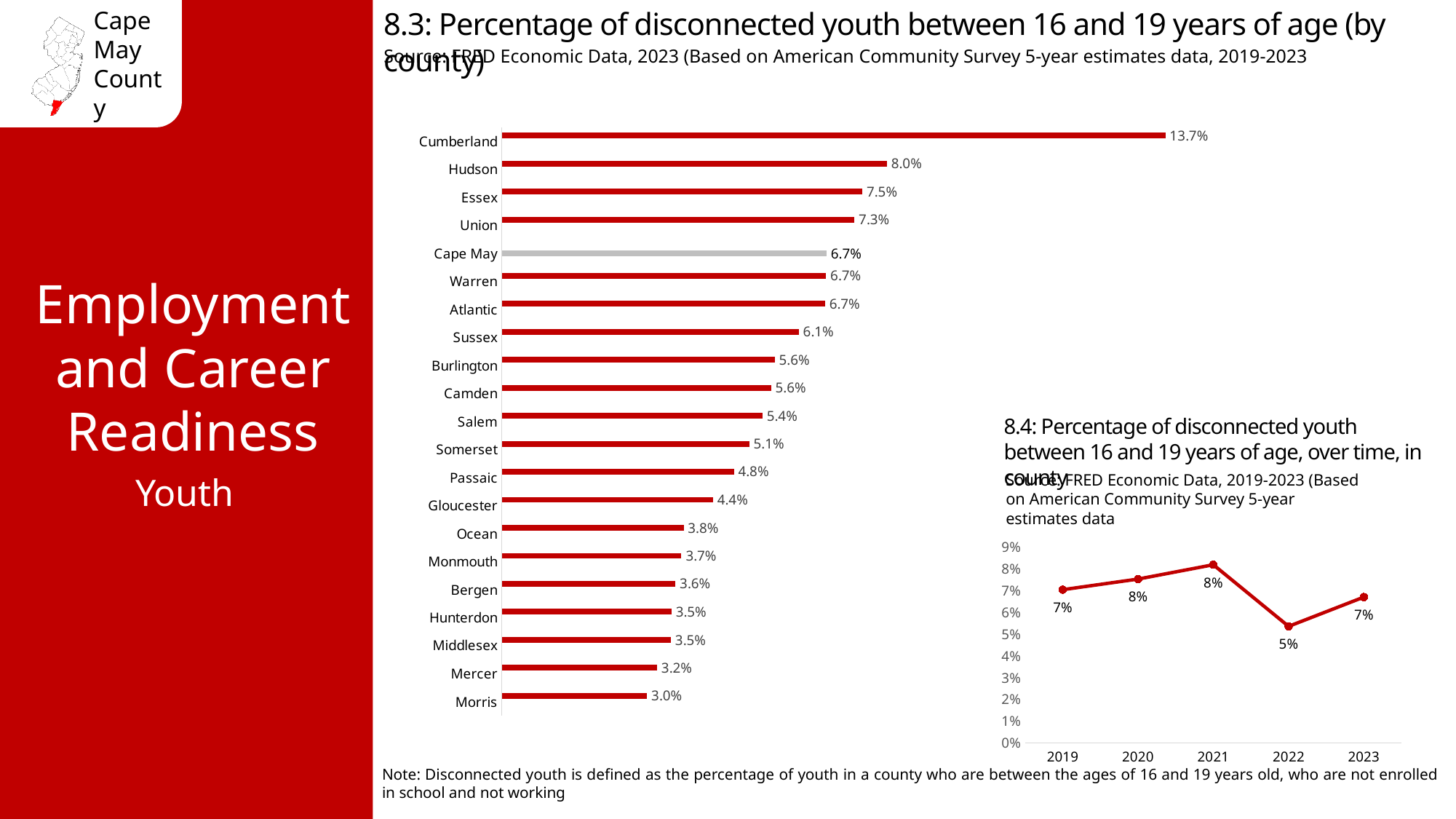
In the chart 8.3 (by county), how many counties are shown? 21 In the chart 8.3 (by county), which county's bar is shown in grey instead of red? Cape May In the chart 8.3 (by county), what is the difference between Cumberland's value and Hudson's value? 5.7 percentage points In the chart 8.3 (by county), what is the value for Mercer? 3.2% What kind of chart is chart 8.3 (by county)? Bar chart In the chart 8.3 (by county), which county has a higher value, Essex or Gloucester? Essex In the chart 8.4 (over time), which year has the lowest value? 2022 In the chart 8.4 (over time), how many years are plotted? 5 In the chart 8.3 (by county), which county has the lowest percentage of disconnected youth? Morris In the chart 8.3 (by county), which county has the highest percentage of disconnected youth? Cumberland In the chart 8.3 (by county), what is the percentage of disconnected youth for Cape May? 6.7% In the chart 8.4 (over time), what is the value for 2022? 5%